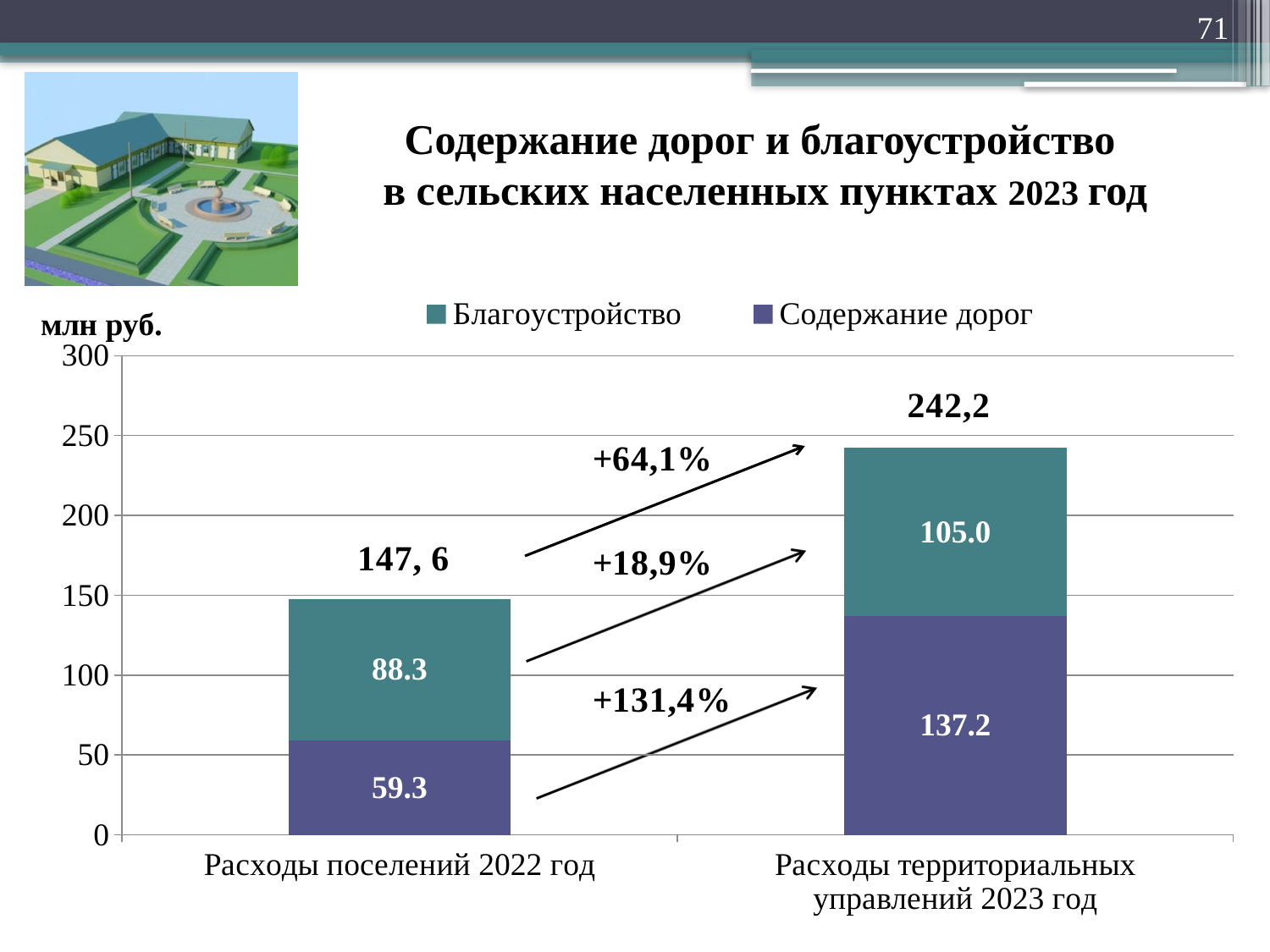
What is the value of Благоустройство for Расходы территориальных управлений 2023 год? 105.0 What unit is shown on the y axis label? млн руб. Which category has the higher total, Расходы поселений 2022 год or Расходы территориальных управлений 2023 год? Расходы территориальных управлений 2023 год What is the total of the stacked bar for Расходы территориальных управлений 2023 год? 242,2 How many categories are shown on the x axis? 2 What is the total of the stacked bar for Расходы поселений 2022 год? 147, 6 What is the value of Благоустройство for Расходы поселений 2022 год? 88.3 What is the difference between the Содержание дорог values for 2023 and 2022? 77.9 What is the value of Содержание дорог for Расходы поселений 2022 год? 59.3 What kind of chart is shown on the slide? stacked bar chart What is the value of Содержание дорог for Расходы территориальных управлений 2023 год? 137.2 How many series does the legend list? 2